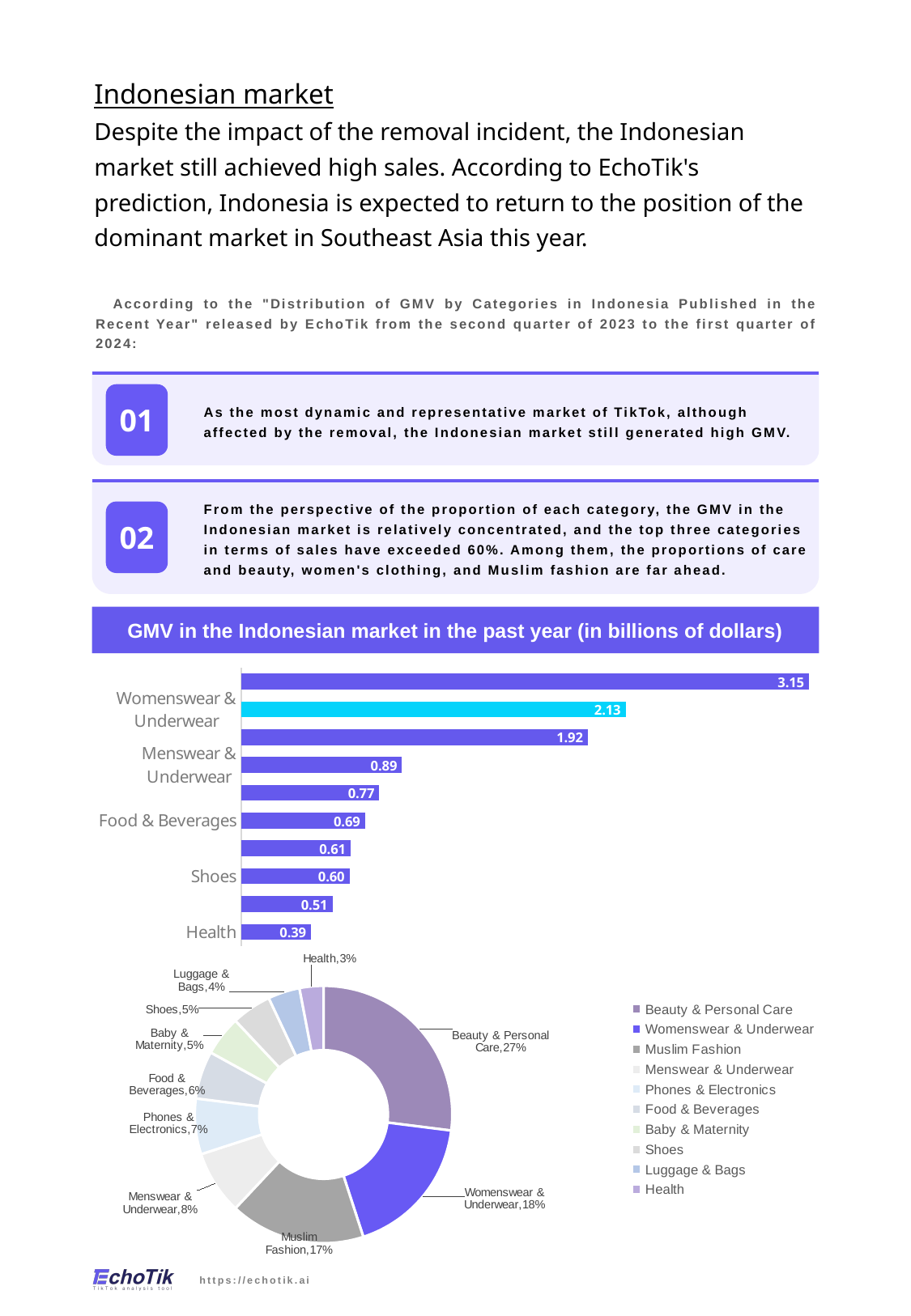
In the pie chart at the bottom of the slide, which category has the smallest slice? Health In the pie chart at the bottom of the slide, what share does Beauty & Personal Care have? 27% How many bars are plotted in the bar chart titled "GMV in the Indonesian market in the past year"? 10 In the pie chart at the bottom of the slide, which category has the largest slice? Beauty & Personal Care In the bar chart titled "GMV in the Indonesian market in the past year", which labeled category has the lowest value? Health What kind of chart is the chart titled "GMV in the Indonesian market in the past year"? Bar chart In the bar chart titled "GMV in the Indonesian market in the past year", what is the value for Womenswear & Underwear? 2.13 In the bar chart titled "GMV in the Indonesian market in the past year", which is larger, the value for Food & Beverages or the value for Shoes? Food & Beverages In the bar chart titled "GMV in the Indonesian market in the past year", what is the difference between the values for Womenswear & Underwear and Menswear & Underwear? 1.24 How many entries does the legend of the pie chart at the bottom of the slide list? 10 In the bar chart titled "GMV in the Indonesian market in the past year", what is the highest value shown on any bar? 3.15 In the bar chart titled "GMV in the Indonesian market in the past year", what is the value for Health? 0.39